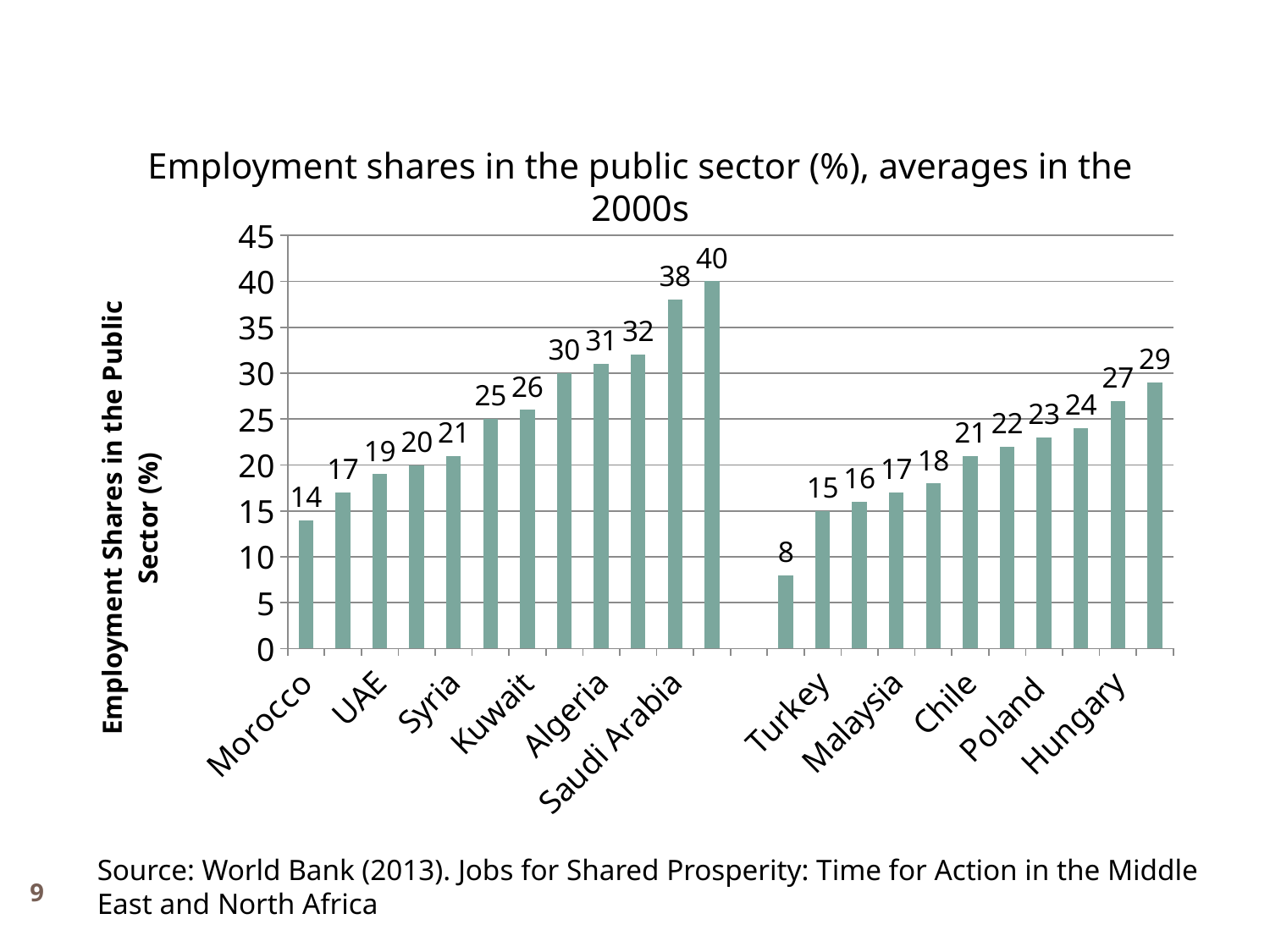
What is the maximum value shown on the vertical axis? 45 Within the right-hand group of countries (Turkey through Hungary), do the bar values rise or fall from left to right? rise Within the left-hand group of countries (Morocco through Saudi Arabia), do the bar values rise or fall from left to right? rise What is the highest value labelled on any bar in the chart? 40 What is the label on the vertical axis of the chart? Employment Shares in the Public Sector (%) What is the title of the chart? Employment shares in the public sector (%), averages in the 2000s Is the value for Morocco greater or less than 15? less What is the lowest value labelled on any bar in the chart? 8 How many bars are plotted in the chart? 23 What is the difference between the highest bar value (40) and the lowest bar value (8)? 32 What kind of chart is shown on the slide? bar chart What is the value shown for Morocco? 14